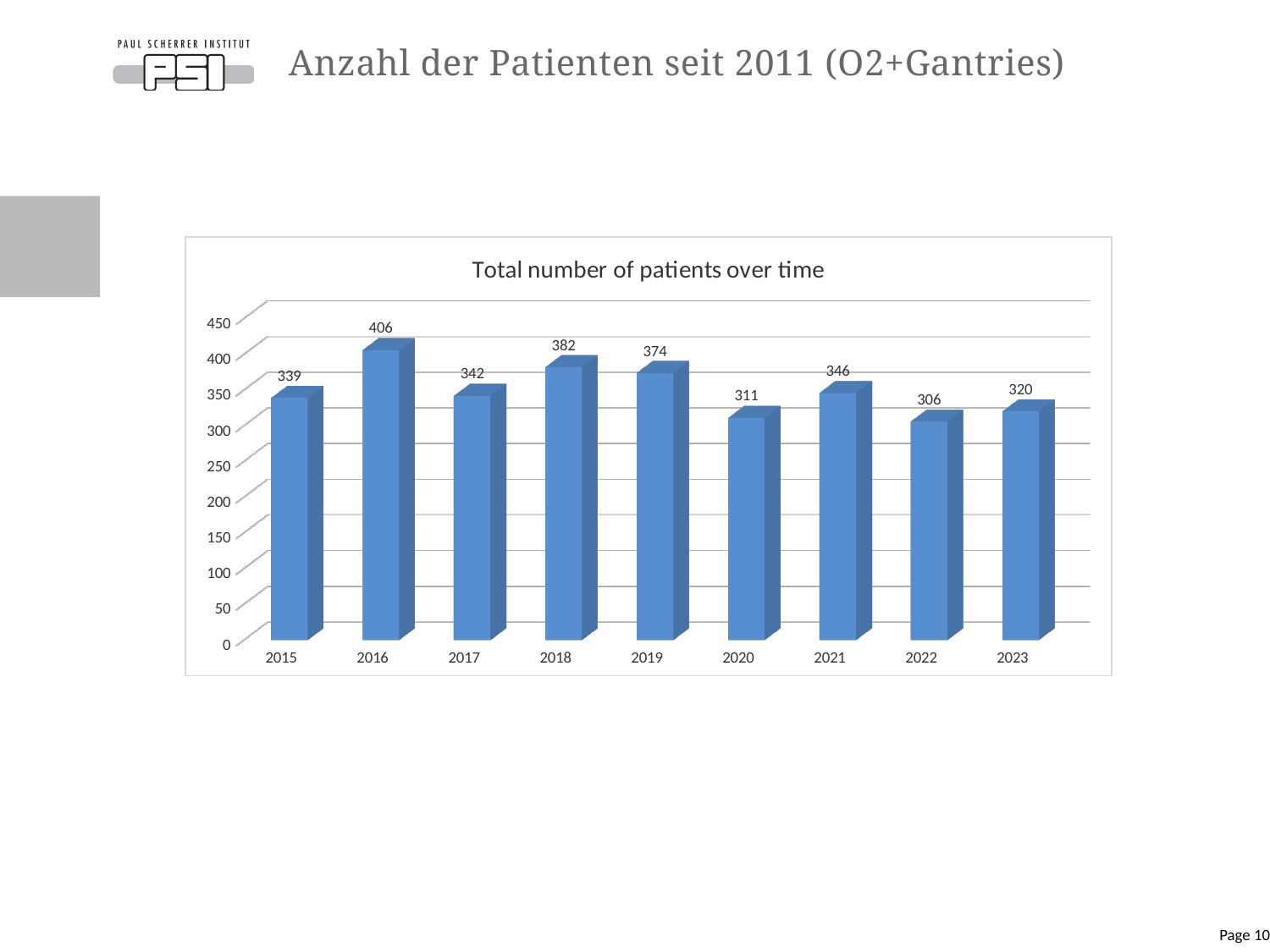
What is the difference between the number of patients in 2018 and in 2017? 40 What is the total number of patients in 2019? 374 What is the title of the chart? Total number of patients over time How many years are shown on the x axis of the chart? 9 What is the total number of patients in 2022? 306 What kind of chart is shown on the slide? bar chart Which year had more patients, 2021 or 2023? 2021 Is the value for 2020 greater or less than 350? less What is the total number of patients in 2016? 406 Which year has the highest total number of patients? 2016 Which year has the lowest total number of patients? 2022 What is the difference between the number of patients in 2016 and in 2022? 100